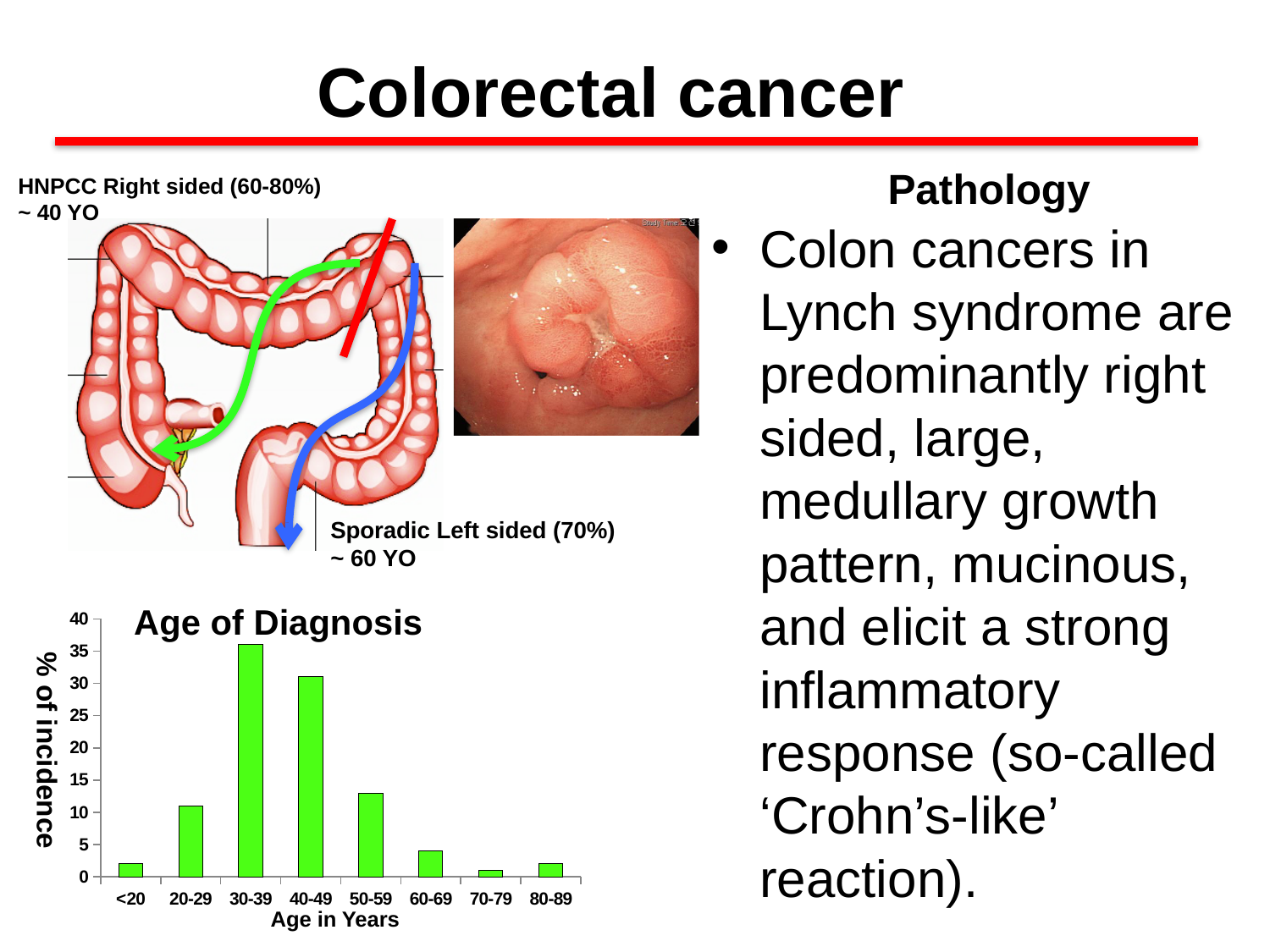
In the "Age of Diagnosis" chart, is the value for 40-49 greater or less than 25? greater In the "Age of Diagnosis" chart, is the value for 20-29 greater or less than 15? less In the "Age of Diagnosis" chart, is the value for 60-69 greater or less than 10? less In the "Age of Diagnosis" chart, which age group has the highest % of incidence? 30-39 What type of chart is the "Age of Diagnosis" chart? bar chart How many age groups are shown on the x axis of the "Age of Diagnosis" chart? 8 In the "Age of Diagnosis" chart, do the values rise or fall from the 30-39 group to the 70-79 group? fall In the "Age of Diagnosis" chart, which age group has a higher % of incidence, 20-29 or 50-59? 50-59 In the "Age of Diagnosis" chart, which age group has a higher % of incidence, 30-39 or 40-49? 30-39 What is the y-axis label of the "Age of Diagnosis" chart? % of incidence